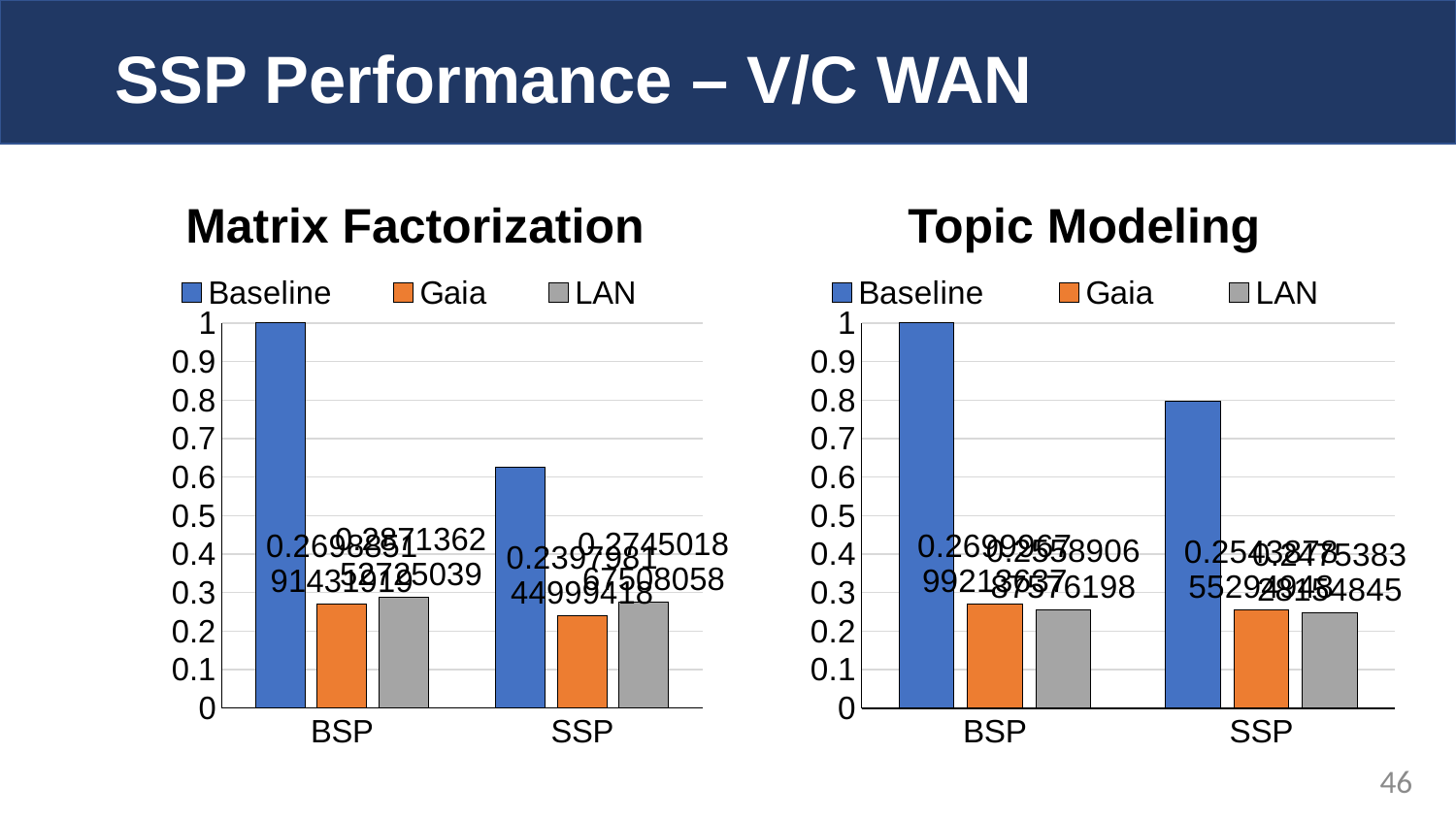
In the Topic Modeling chart, which series has the highest value for SSP? Baseline In the Matrix Factorization chart, is the Gaia value for BSP greater or less than 0.4? less In the Matrix Factorization chart, which series has the highest value for BSP? Baseline How many categories are shown on the x axis of the Matrix Factorization chart? 2 In the Matrix Factorization chart, is the Baseline value for BSP larger or smaller than the Baseline value for SSP? larger In the Topic Modeling chart, is the Baseline value for SSP greater or less than 0.7? greater How many series does the legend of the Topic Modeling chart list? 3 In the Topic Modeling chart, what is the Baseline value for BSP? 1 In the Matrix Factorization chart, is the Baseline value for SSP greater or less than 0.5? greater In the Matrix Factorization chart, what is the Baseline value for BSP? 1 What kind of chart is the Topic Modeling chart? bar chart